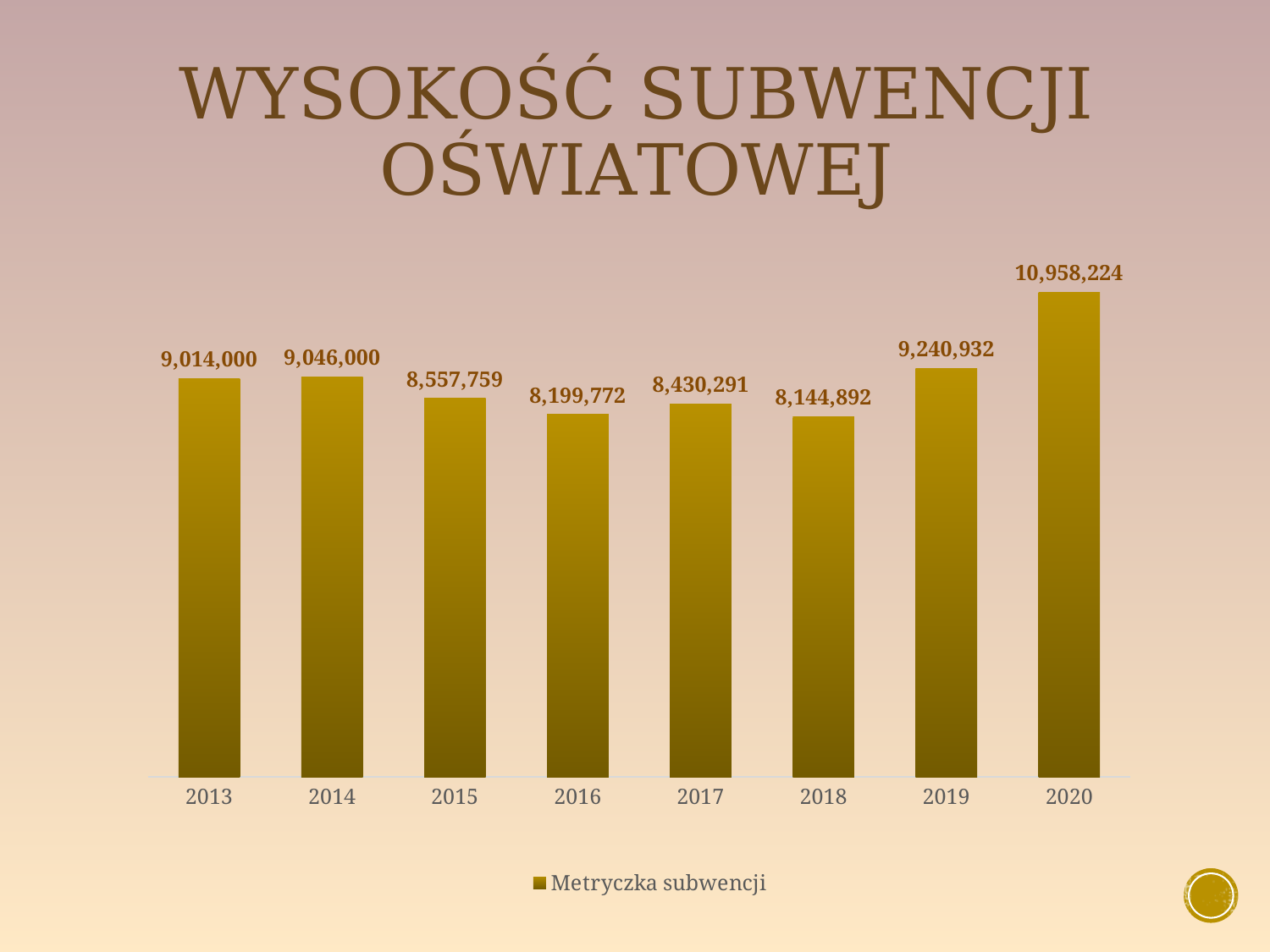
What is the value for 2018? 8,144,892 How many series does the legend list? 1 What kind of chart is shown on the slide? bar chart What is the difference between the values for 2014 and 2013? 32,000 How many years are shown on the x axis? 8 Which year has the highest value? 2020 What is the value for 2015? 8,557,759 What is the value for 2020? 10,958,224 Which year has the lowest value? 2018 Which is larger, the value for 2017 or the value for 2016? 2017 What is the difference between the values for 2020 and 2019? 1,717,292 What is the legend entry for the series? Metryczka subwencji